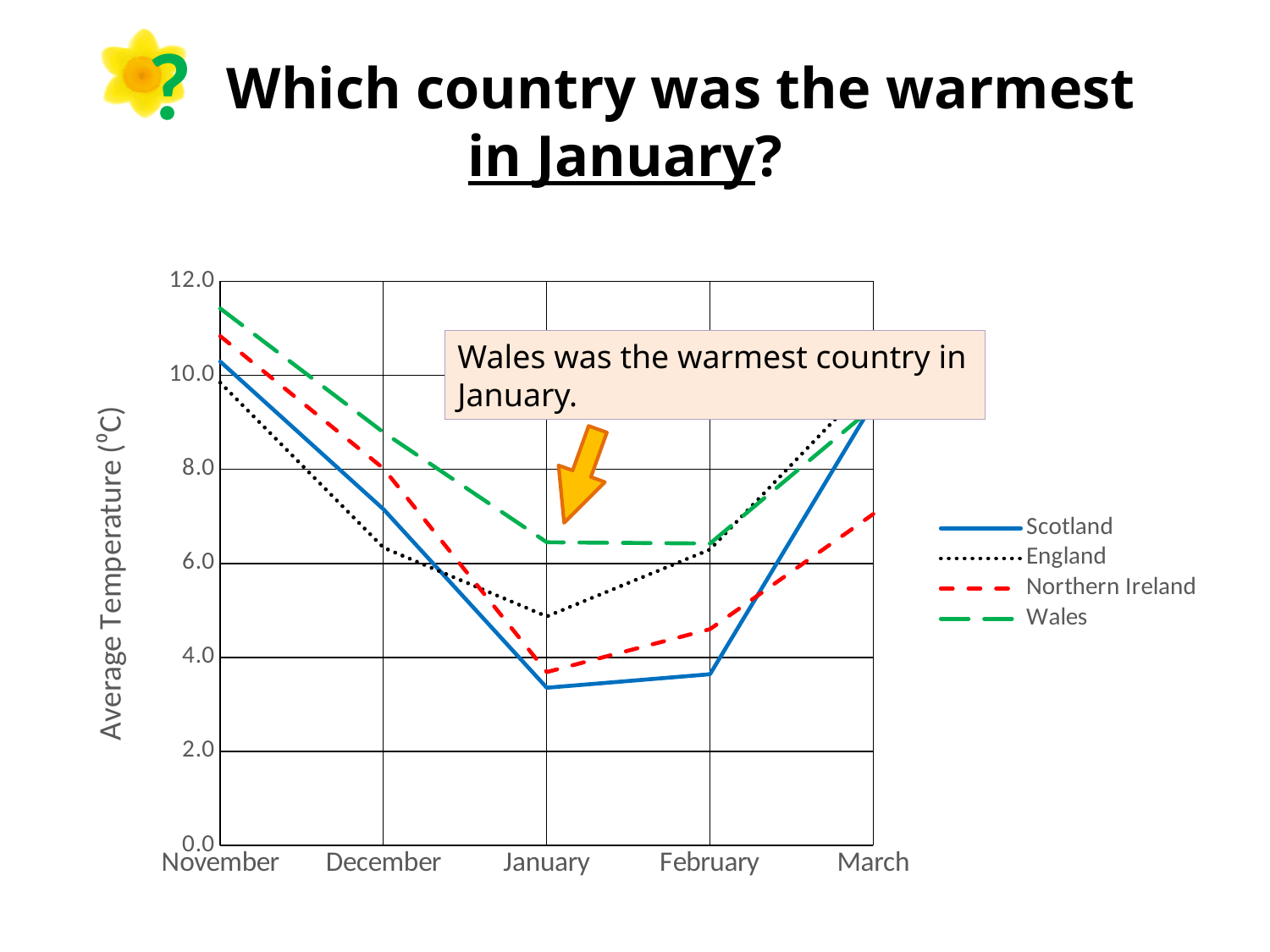
Which country had the lowest average temperature in November? England How many series does the legend list? 4 Which country had the highest average temperature in November? Wales Which country had the highest average temperature in January? Wales How many months are shown along the x axis? 5 Is the average temperature for Wales in January greater or less than 6.0? greater Is the average temperature for Scotland in January greater or less than 4.0? less Does the average temperature for Scotland rise or fall from November to January? fall What kind of chart is shown on the slide? line chart What is the title of the vertical axis? Average Temperature (°C) Which was higher in November, the average temperature for Wales or for Scotland? Wales Is the average temperature for England in January greater or less than 4.0? greater